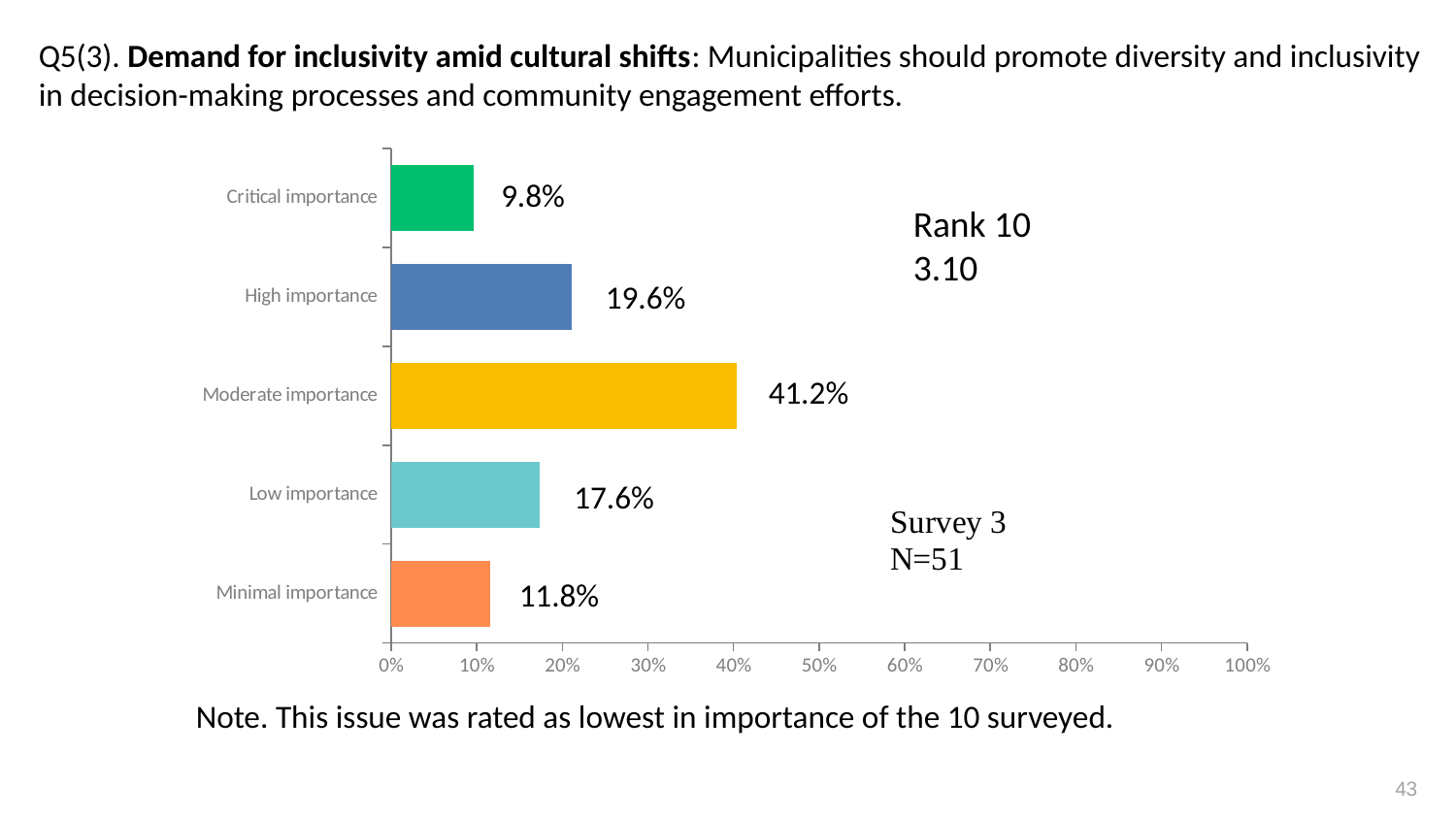
Which is larger, the value for Low importance or the value for Minimal importance? Low importance What kind of chart is shown on the slide? Bar chart What colour is the bar for Moderate importance? Yellow Is the value for Moderate importance greater or less than 40%? greater How many importance categories are shown in the chart? 5 What is the difference between the High importance and Critical importance percentages? 9.8% What is the value for Low importance? 17.6% Which importance category has the lowest percentage? Critical importance What percentage of respondents rated this issue as Critical importance? 9.8% What percentage of respondents rated this issue as Moderate importance? 41.2% Which importance category has the highest percentage? Moderate importance What is the difference between the Moderate importance and Low importance percentages? 23.6%